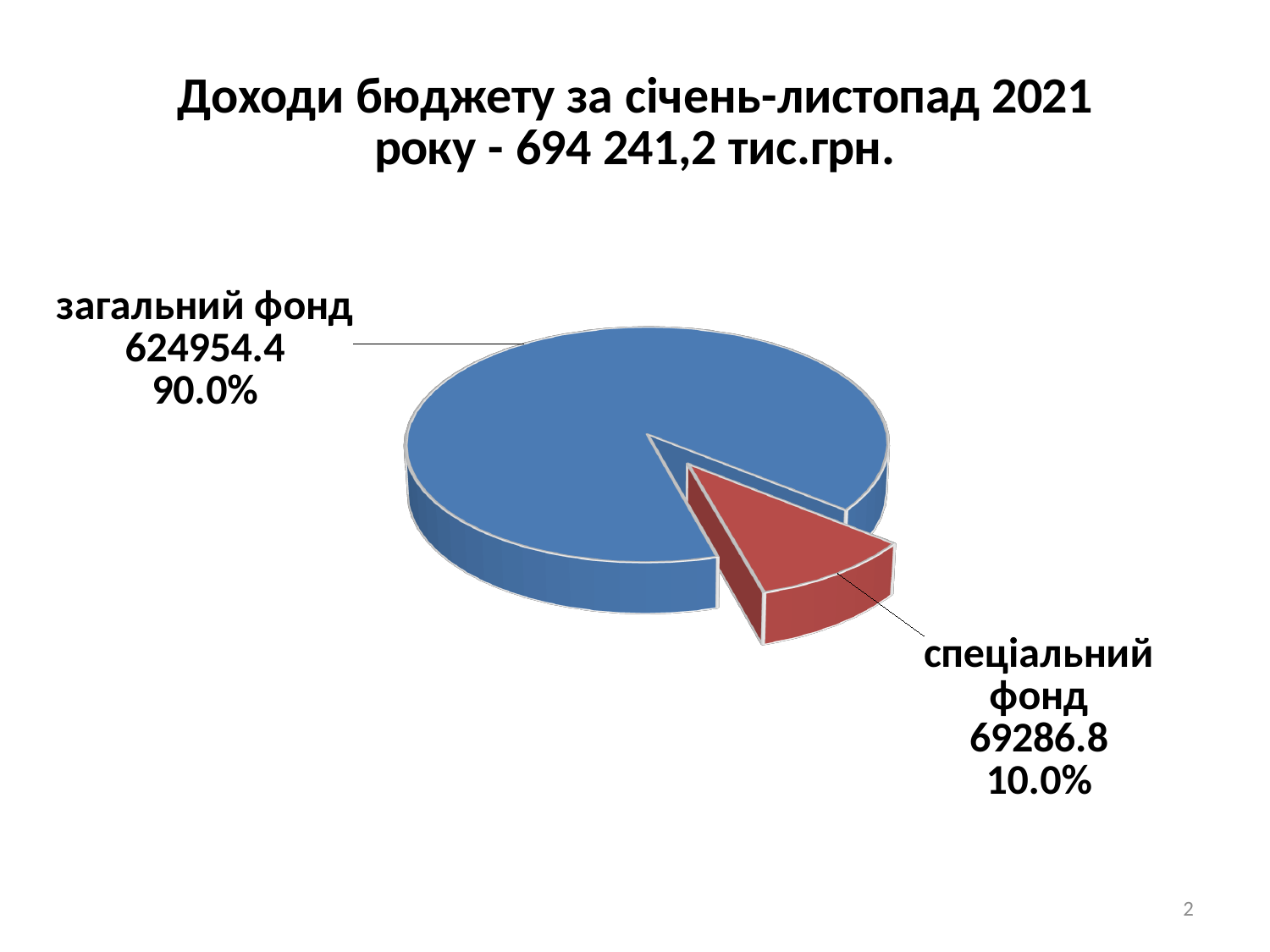
What is the title of the chart? Доходи бюджету за січень-листопад 2021 року - 694 241,2 тис.грн. What share of the pie does загальний фонд represent? 90.0% What colour is the slice for спеціальний фонд? red What share of the pie does спеціальний фонд represent? 10.0% What is the value for спеціальний фонд? 69286.8 Which is larger, загальний фонд or спеціальний фонд? загальний фонд What kind of chart is shown on the slide? pie chart Which category has the largest slice? загальний фонд What is the value for загальний фонд? 624954.4 How many slices does the pie chart have? 2 What is the difference between the values for загальний фонд and спеціальний фонд? 555667.6 Which category has the smallest slice? спеціальний фонд